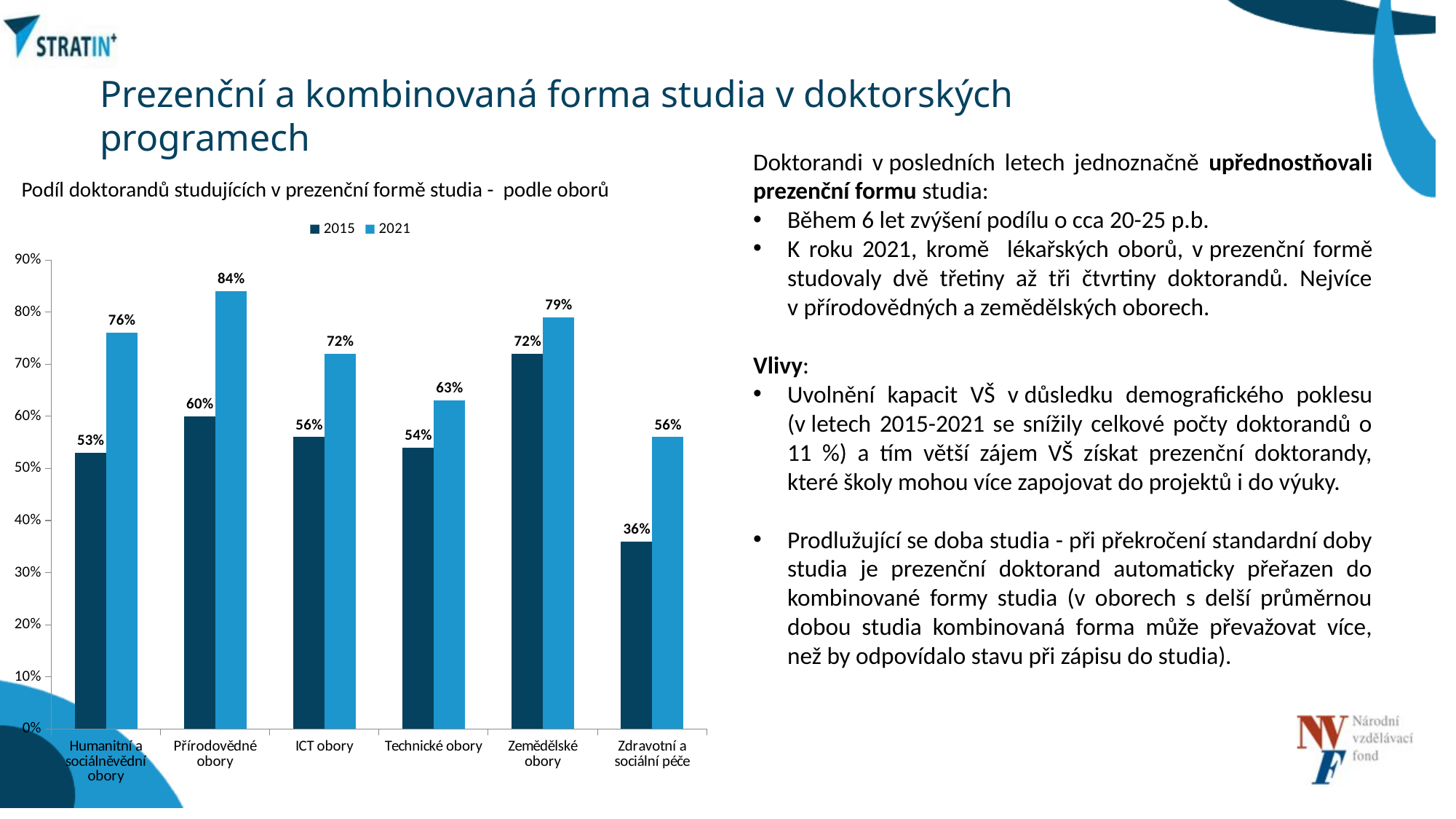
Is the 2021 value for Zemědělské obory greater or less than 70%? greater How many categories are shown on the x axis? 6 What are the two series named in the legend? 2015 and 2021 What is the difference between the 2021 and 2015 values for Humanitní a sociálněvědní obory? 23 percentage points What kind of chart is shown on the slide? Bar chart Which category has the lowest 2015 value? Zdravotní a sociální péče What is the 2015 value for Zemědělské obory? 72% Which category has the highest 2021 value? Přírodovědné obory What is the 2015 value for Zdravotní a sociální péče? 36% Which is larger: the 2021 value for ICT obory or the 2021 value for Technické obory? ICT obory What is the 2021 value for Přírodovědné obory? 84% How many series does the legend list? 2